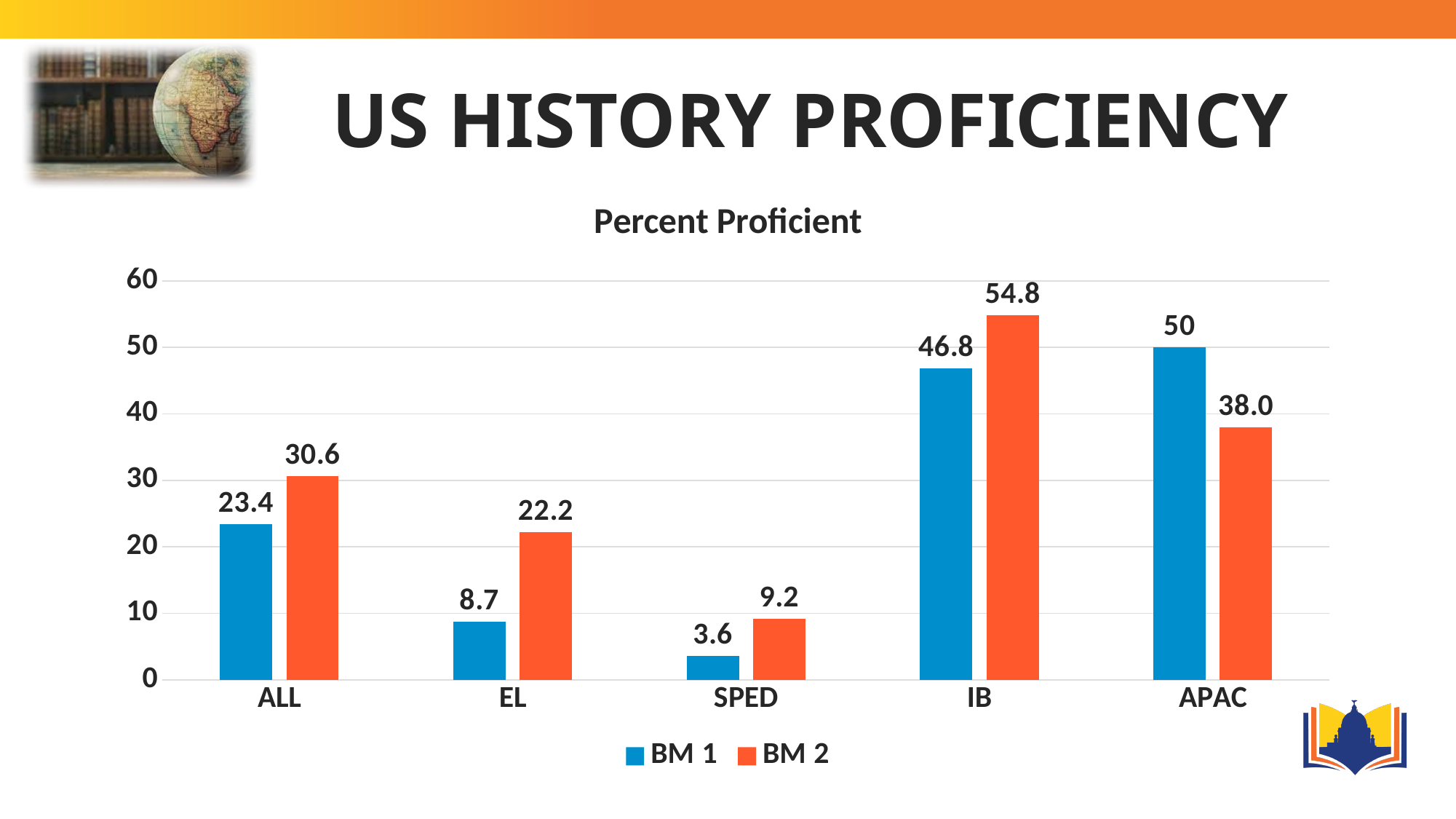
Which category has the highest BM 2 value? IB How many series does the legend list? 2 What is the BM 2 value for SPED? 9.2 What is the difference between the BM 2 and BM 1 values for EL? 13.5 What is the BM 1 value for ALL? 23.4 How many categories are shown on the x axis? 5 What is the title of the chart? Percent Proficient Which is larger for APAC, BM 1 or BM 2? BM 1 What is the BM 2 value for APAC? 38.0 Is the BM 1 value for IB greater or less than 40? greater What kind of chart is shown on the slide? bar chart Which category has the lowest BM 1 value? SPED